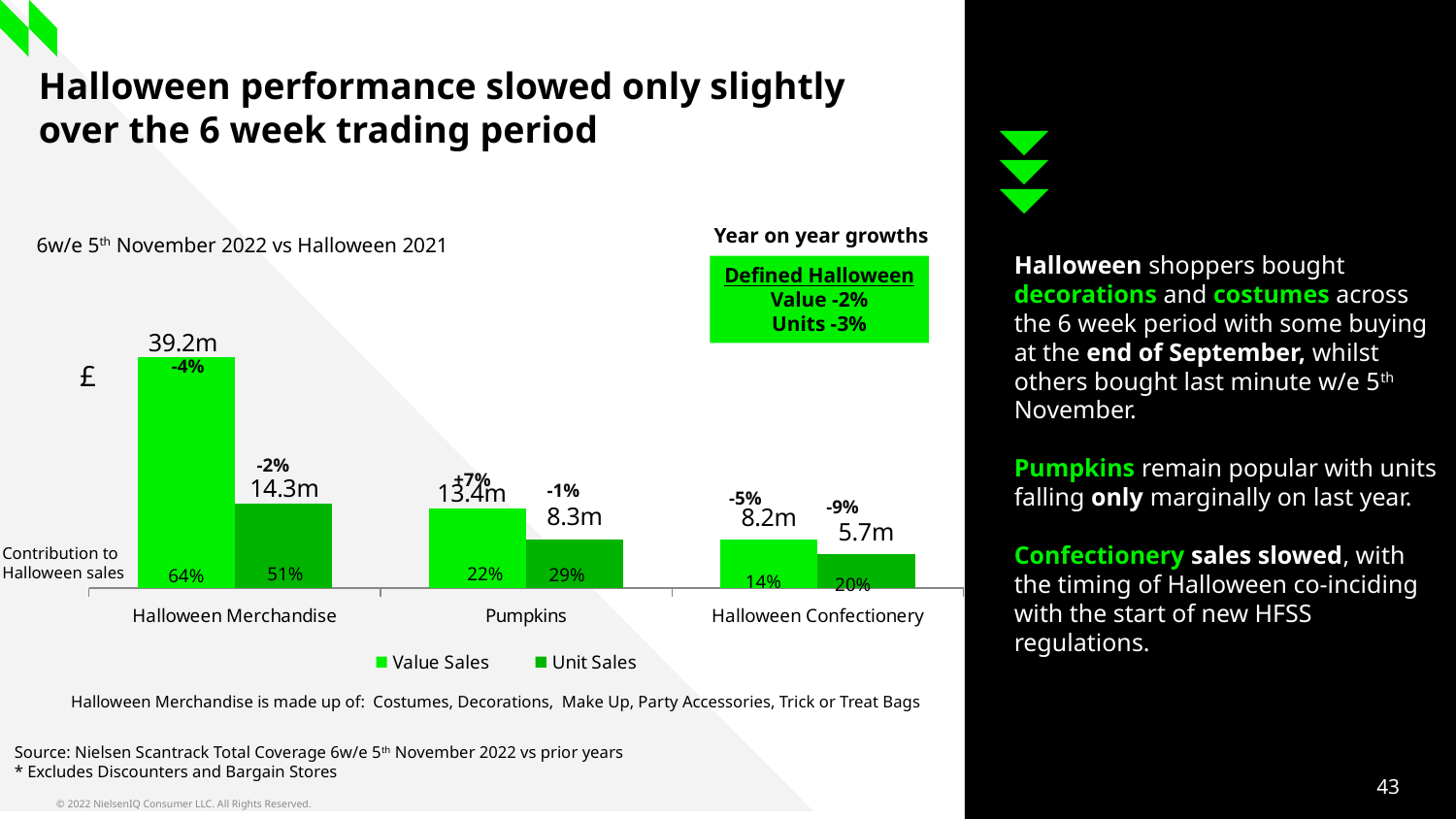
What is the Unit Sales figure for Pumpkins? 8.3m What contribution to Halloween sales is shown on the Value Sales bar for Pumpkins? 22% What kind of chart is shown on the slide? Bar chart What year-on-year growth is shown above the Unit Sales bar for Halloween Confectionery? -9% What is the Value Sales figure for Halloween Merchandise? 39.2m Which category has the highest Value Sales? Halloween Merchandise How many series does the chart legend list? 2 Which category has the lowest Unit Sales? Halloween Confectionery Which is larger, the Value Sales for Pumpkins or the Value Sales for Halloween Confectionery? Value Sales for Pumpkins How many categories are shown on the x axis of the chart? 3 What is the difference between Value Sales and Unit Sales for Halloween Merchandise? 24.9m What is the Value Sales figure for Halloween Confectionery? 8.2m